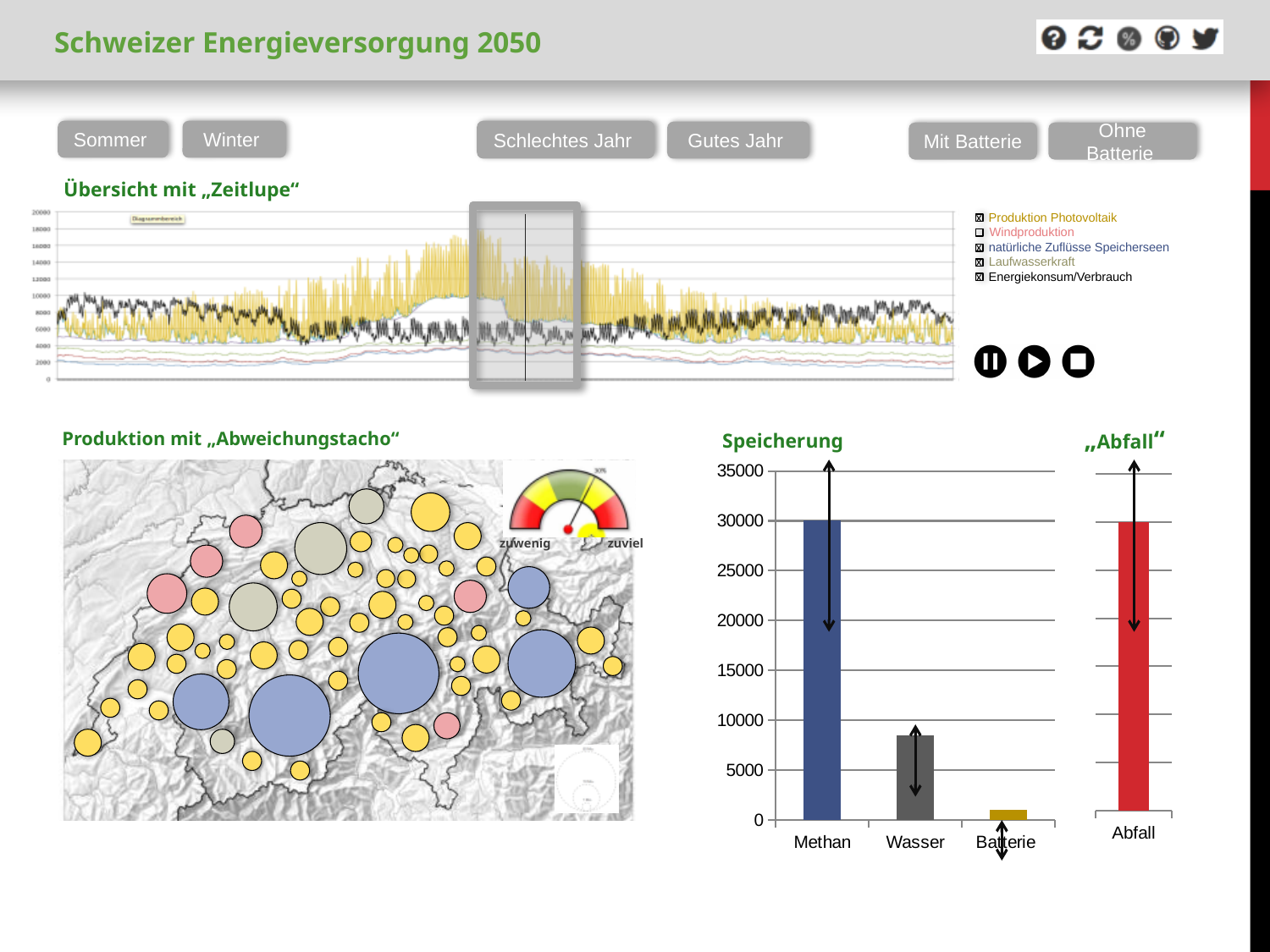
In the "Speicherung" chart, is the value for Wasser greater or less than 5000? greater How many categories are shown in the "Speicherung" chart? 3 In the "Speicherung" chart, which category has the lowest value? Batterie In the "Speicherung" chart, what is the value for Methan? 30000 How many bars are shown in the "Abfall" chart? 1 In the "Speicherung" chart, which category has the highest value? Methan In the "Speicherung" chart, is the value for Wasser greater or less than 10000? less How many entries does the legend of the "Übersicht mit Zeitlupe" chart list? 5 In the "Speicherung" chart, which is larger, Methan or Wasser? Methan What is the highest value labelled on the y axis of the "Speicherung" chart? 35000 In the "Speicherung" chart, is the value for Batterie greater or less than 5000? less What kind of chart is the "Speicherung" chart? bar chart